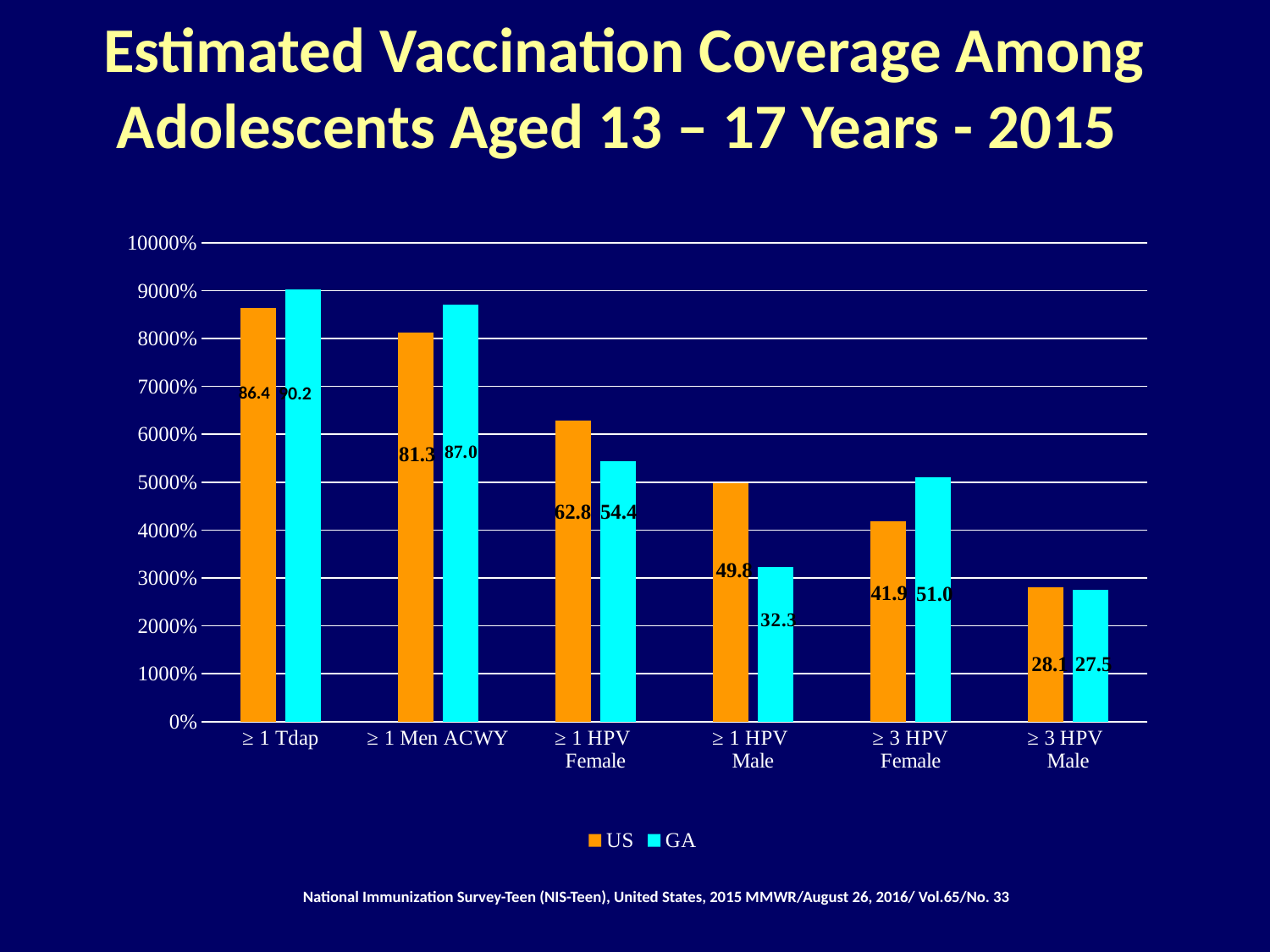
What kind of chart is shown on the slide? Bar chart What is the GA value for ≥ 1 HPV Male? 32.3 What is the US value for ≥ 3 HPV Female? 41.9 How many series does the legend list? 2 Which category has the lowest US value? ≥ 3 HPV Male What is the US value for ≥ 1 Tdap? 86.4 Which category has the highest GA value? ≥ 1 Tdap What is the difference between the GA and US values for ≥ 1 Tdap? 3.8 What is the GA value for ≥ 1 Men ACWY? 87.0 For ≥ 1 HPV Female, which is larger, the US value or the GA value? US How many categories are shown on the x axis? 6 What is the difference between the US and GA values for ≥ 1 HPV Male? 17.5